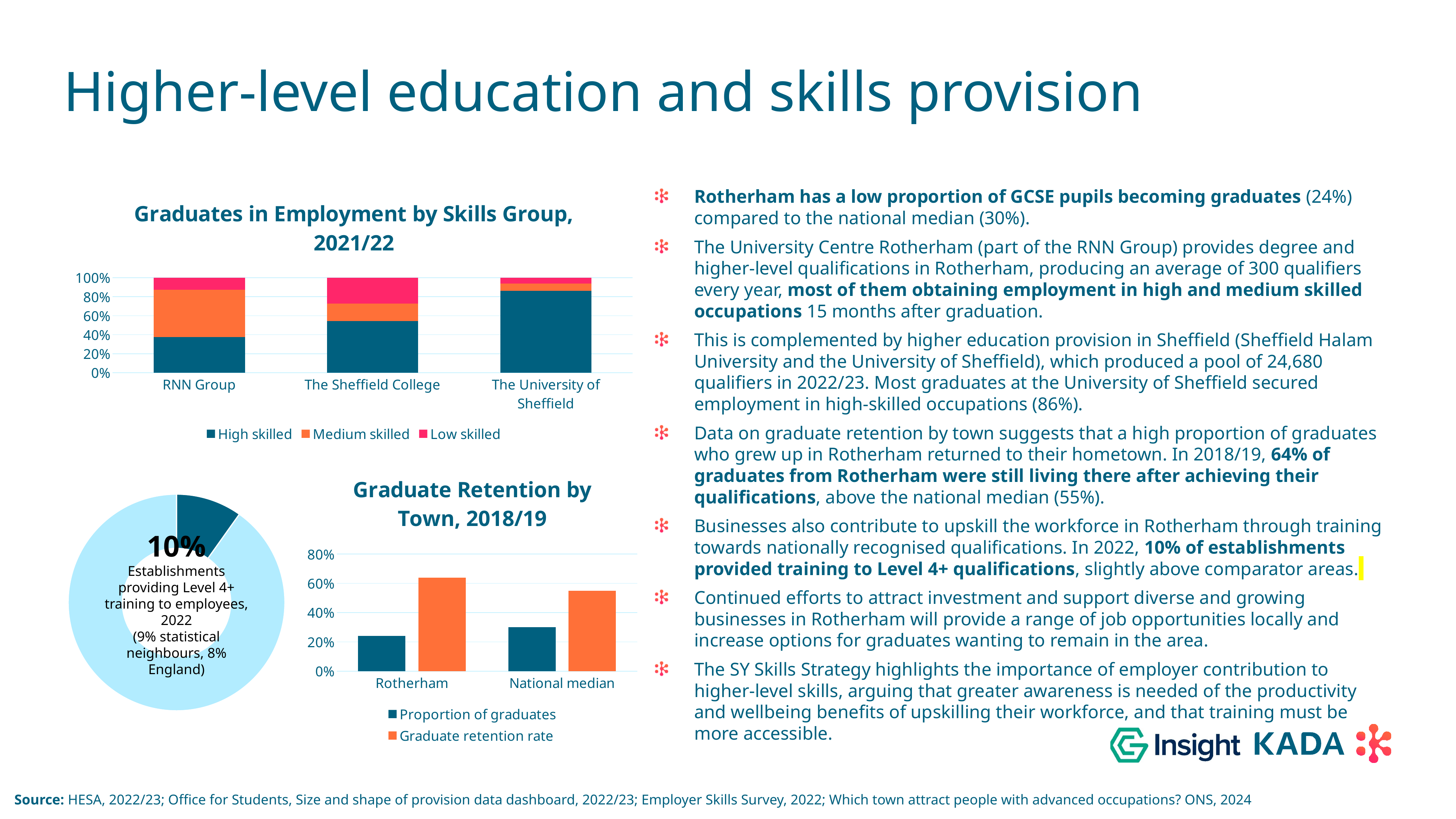
In the "Graduates in Employment by Skills Group, 2021/22" chart, which institution has the largest High skilled share? The University of Sheffield How many series does the legend of the "Graduates in Employment by Skills Group, 2021/22" chart list? 3 In the "Graduates in Employment by Skills Group, 2021/22" chart, which institution has the largest Low skilled share? The Sheffield College How many institutions are shown on the x axis of the "Graduates in Employment by Skills Group, 2021/22" chart? 3 In the "Graduates in Employment by Skills Group, 2021/22" chart, is the High skilled share for RNN Group greater or less than 60%? less In the "Graduate Retention by Town, 2018/19" chart, which has the higher Graduate retention rate, Rotherham or National median? Rotherham What kind of chart is "Graduate Retention by Town, 2018/19"? Bar chart What percentage is shown in the centre of the donut chart on the lower left of the slide? 10% In the "Graduates in Employment by Skills Group, 2021/22" chart, is the High skilled share for The University of Sheffield greater or less than 80%? greater What kind of chart is "Graduates in Employment by Skills Group, 2021/22"? Stacked bar chart How many series does the legend of the "Graduate Retention by Town, 2018/19" chart list? 2 In the "Graduate Retention by Town, 2018/19" chart, is the Proportion of graduates for Rotherham greater or less than 40%? less